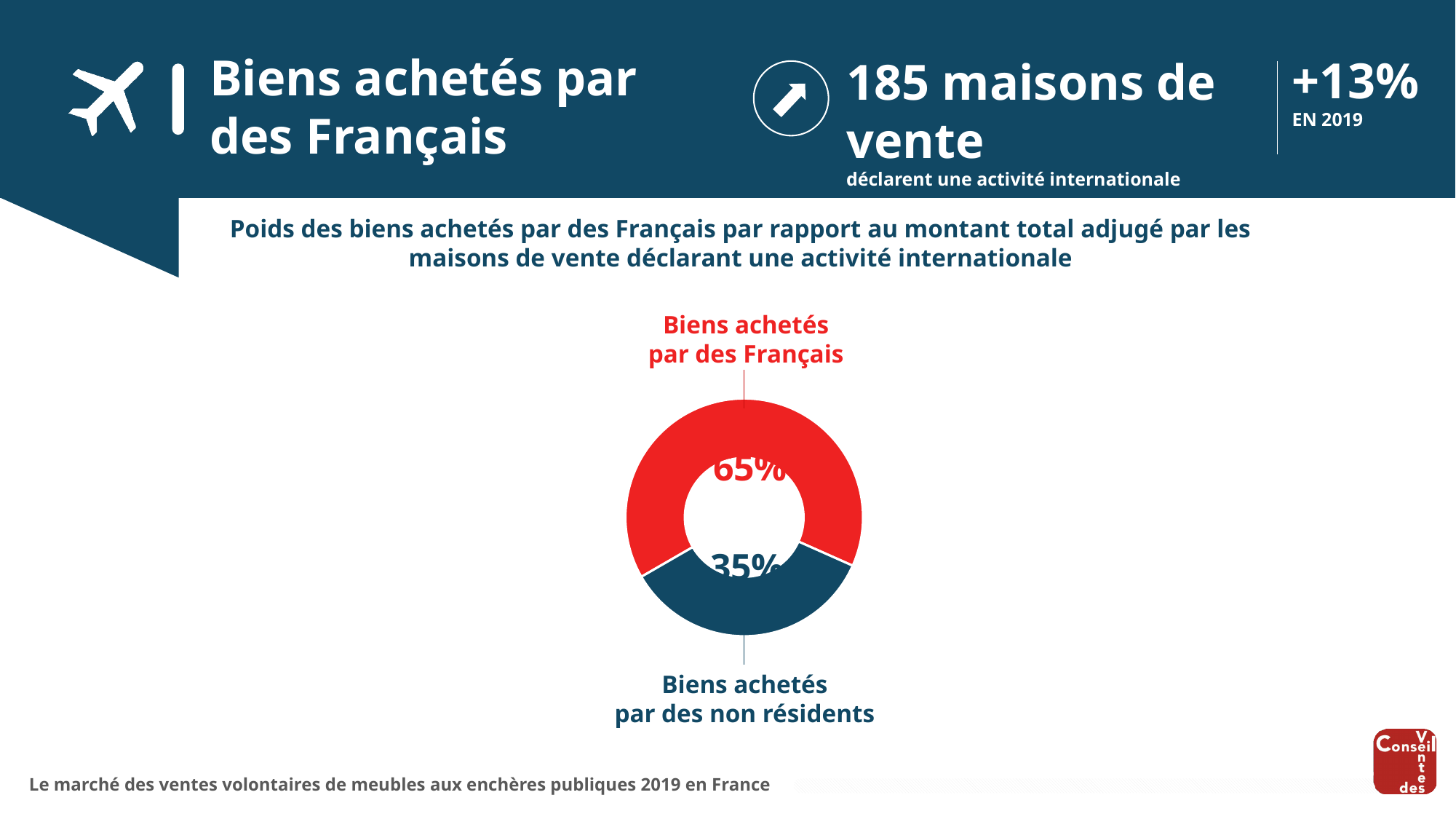
Which is larger: the share for 'Biens achetés par des Français' or the share for 'Biens achetés par des non résidents'? Biens achetés par des Français What share of the donut chart is labelled 'Biens achetés par des Français'? 65% Which segment of the donut chart is the smallest? Biens achetés par des non résidents How many segments does the donut chart have? 2 Do the two segments of the donut chart add up to 100%? Yes What share of the donut chart is labelled 'Biens achetés par des non résidents'? 35% Is the share for 'Biens achetés par des non résidents' greater or less than 50%? less What colour is the 'Biens achetés par des Français' segment of the donut chart? Red What colour is the 'Biens achetés par des non résidents' segment of the donut chart? Dark blue What is the difference in percentage points between the 'Biens achetés par des Français' segment and the 'Biens achetés par des non résidents' segment? 30 percentage points What type of chart is shown on the slide? Donut (pie) chart Which segment of the donut chart is the largest? Biens achetés par des Français